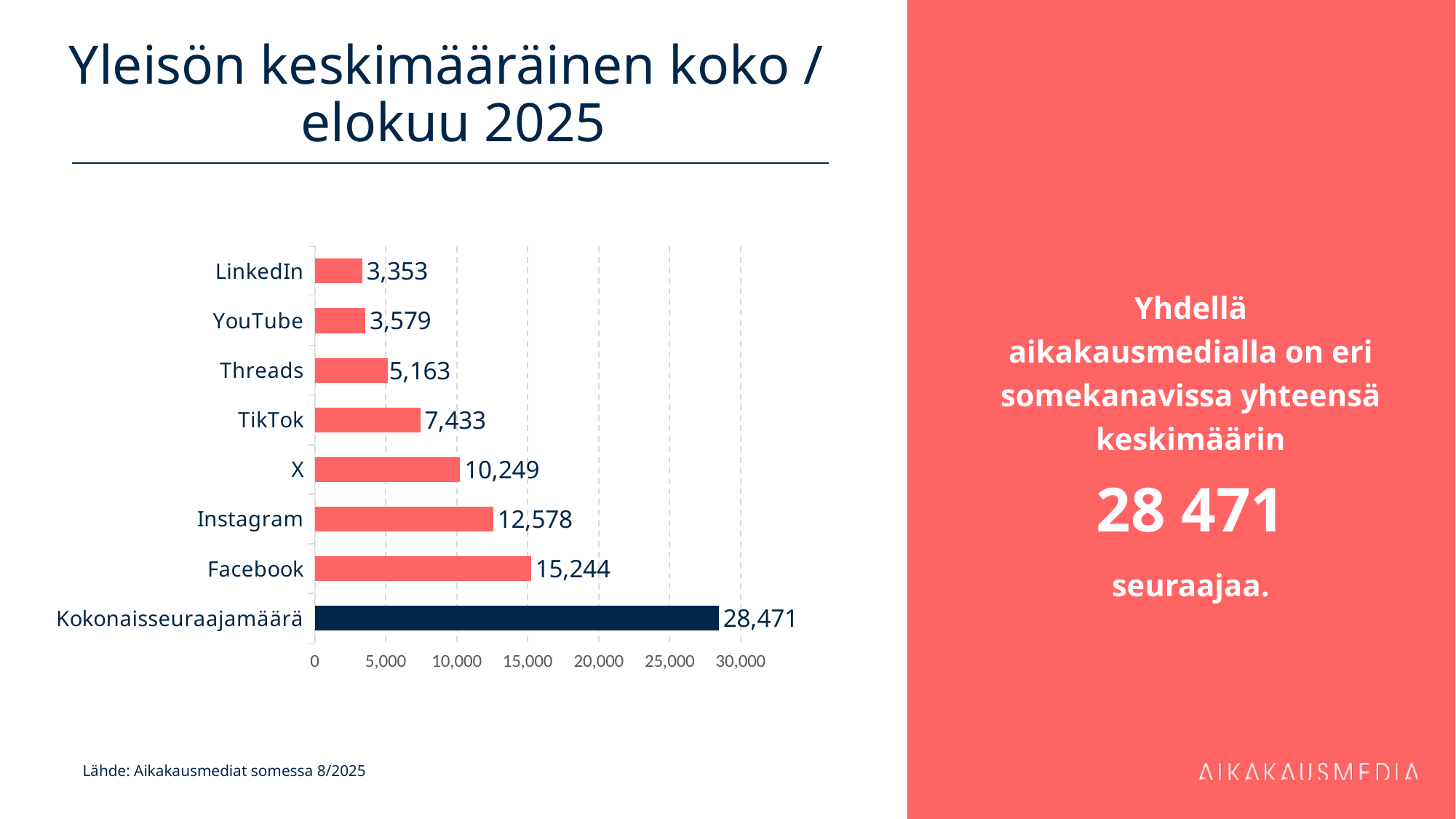
What kind of chart is shown on the slide? Bar chart What is the title of the slide? Yleisön keskimääräinen koko / elokuu 2025 What is the value for Kokonaisseuraajamäärä? 28,471 How many categories are shown in the chart? 8 What is the difference between the values for Facebook and Instagram? 2,666 What is the value for Facebook? 15,244 Which category has the highest value? Kokonaisseuraajamäärä What is the value for TikTok? 7,433 What is the difference between the values for YouTube and LinkedIn? 226 Which is larger, the value for X or the value for Threads? X Is the value for Instagram greater or less than 10,000? greater Which category has the lowest value? LinkedIn